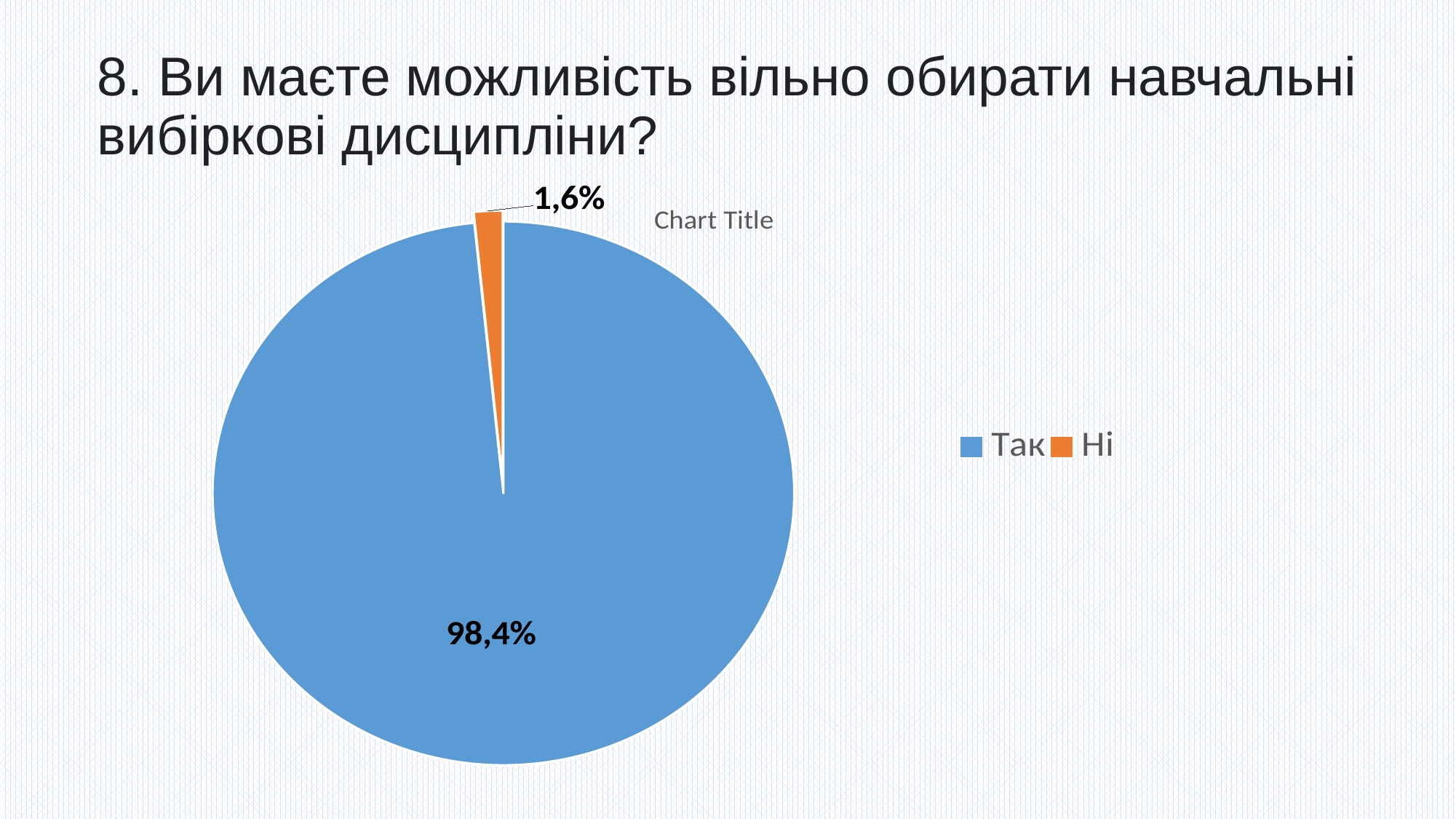
What is the title shown inside the chart area? Chart Title What colour is the slice for Ні? orange What kind of chart is shown on the slide? pie chart Which category has the largest slice? Так What is the difference between the values for Так and Ні? 96,8% What share of the pie does Так take? 98,4% Which is larger, Так or Ні? Так What is the value for Так? 98,4% What is the value for Ні? 1,6% Which category has the smallest slice? Ні How many slices does the pie chart have? 2 How many entries does the legend list? 2